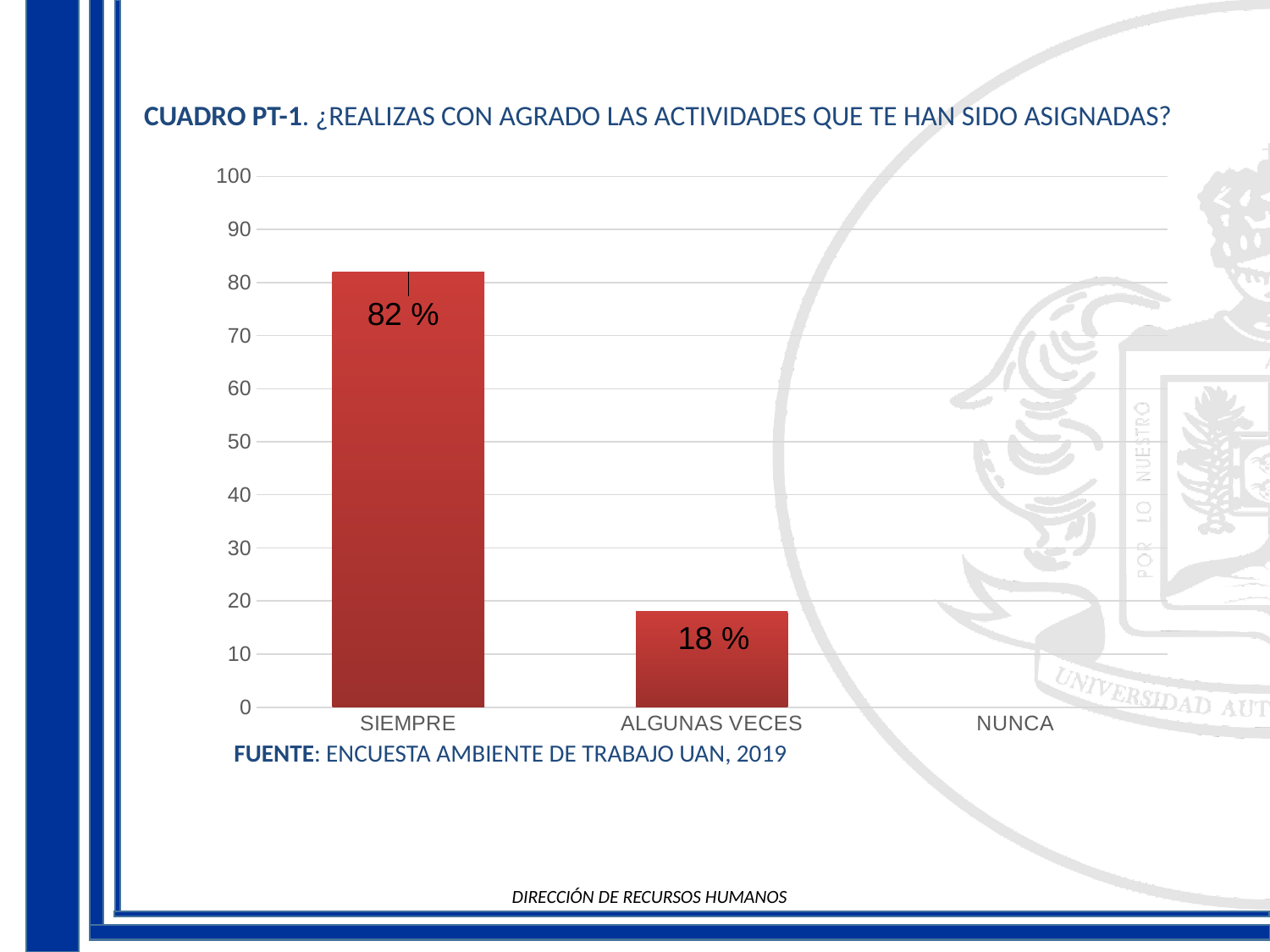
Do the values rise or fall from SIEMPRE to ALGUNAS VECES? fall Which category has the highest value? SIEMPRE What is the title of the chart? CUADRO PT-1. ¿REALIZAS CON AGRADO LAS ACTIVIDADES QUE TE HAN SIDO ASIGNADAS? Is the value for ALGUNAS VECES greater or less than 20? less How many categories are shown on the x axis? 3 What is the difference between the values for SIEMPRE and ALGUNAS VECES? 64 % What is the value for SIEMPRE? 82 % What source is cited below the chart? ENCUESTA AMBIENTE DE TRABAJO UAN, 2019 Is the value for SIEMPRE greater or less than 50? greater What is the value for ALGUNAS VECES? 18 % What kind of chart is shown on the slide? bar chart Which is larger, the value for SIEMPRE or the value for ALGUNAS VECES? SIEMPRE